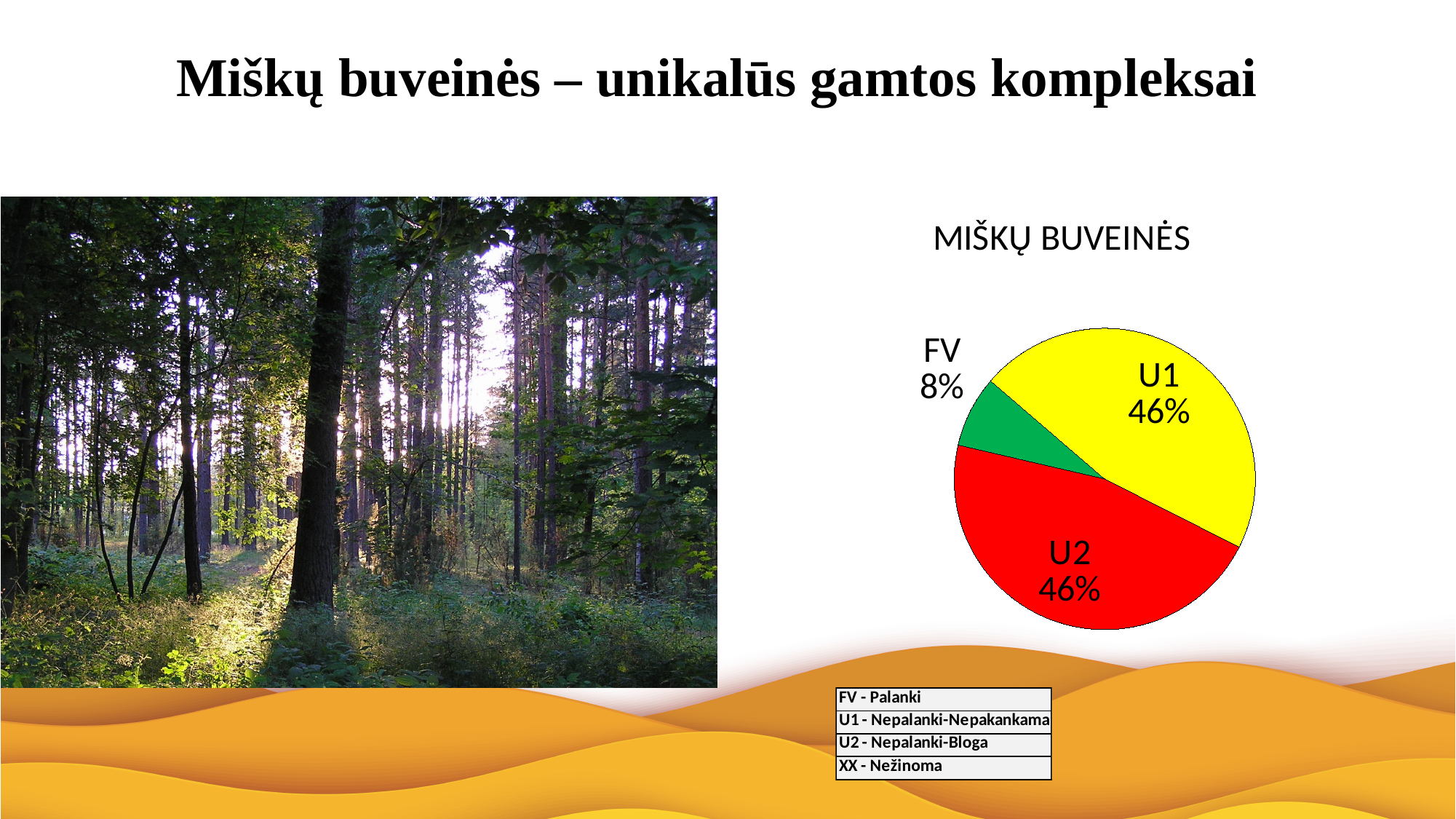
What colour is the U2 slice of the pie chart? Red Do the U1 and U2 slices have the same share of the pie? Yes Which is larger, the U1 slice or the FV slice? U1 What share of the pie does U2 represent? 46% What kind of chart is shown on the slide? Pie chart How many slices does the pie chart have? 3 What share of the pie does FV represent? 8% What share of the pie does U1 represent? 46% Which slice of the pie chart is the smallest? FV What is the title of the pie chart? MIŠKŲ BUVEINĖS What is the difference in percentage points between the U2 slice and the FV slice? 38